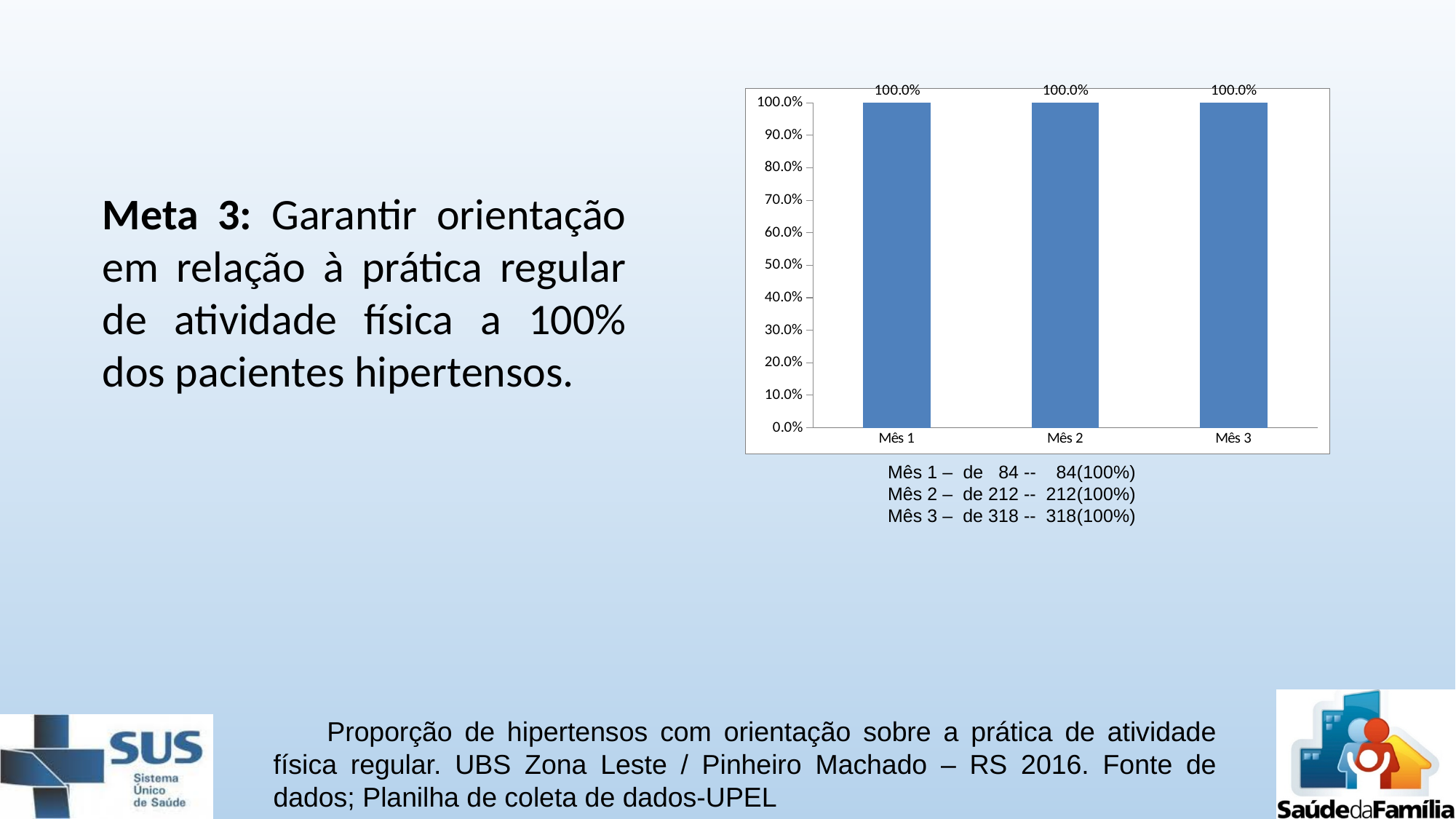
What is the label of the first category on the x axis? Mês 1 What is the value for Mês 3? 100.0% What is the value for Mês 1? 100.0% What kind of chart is shown on the slide? Bar chart Is the value for Mês 2 greater or less than 90.0%? greater How many categories are shown on the x axis of the chart? 3 What is the difference between the values for Mês 3 and Mês 1? 0.0% What is the value for Mês 2? 100.0% Do the values rise, fall, or stay the same from Mês 1 to Mês 3? Stay the same What is the highest tick value shown on the y axis? 100.0%